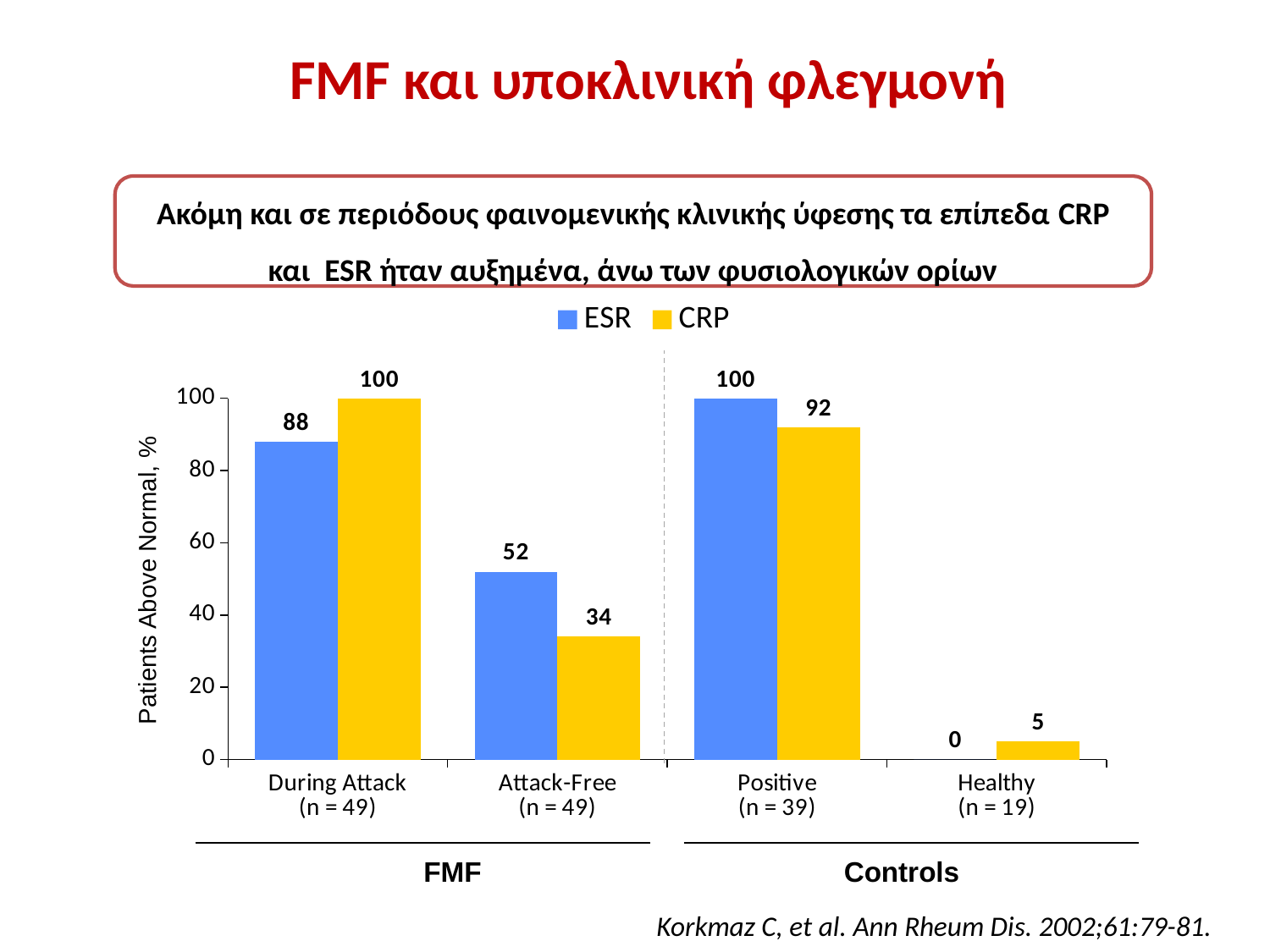
Which category has the highest ESR value? Positive What is the difference between the ESR and CRP values for Attack-Free? 18 What is the CRP value for Attack-Free? 34 How many series does the legend list? 2 What is the label of the y axis? Patients Above Normal, % What is the ESR value for During Attack? 88 Which category has the lowest CRP value? Healthy Which is larger for During Attack, the ESR value or the CRP value? CRP What kind of chart is shown on the slide? Bar chart What is the ESR value for Healthy controls? 0 How many categories are shown on the x axis? 4 What is the CRP value for Positive controls? 92